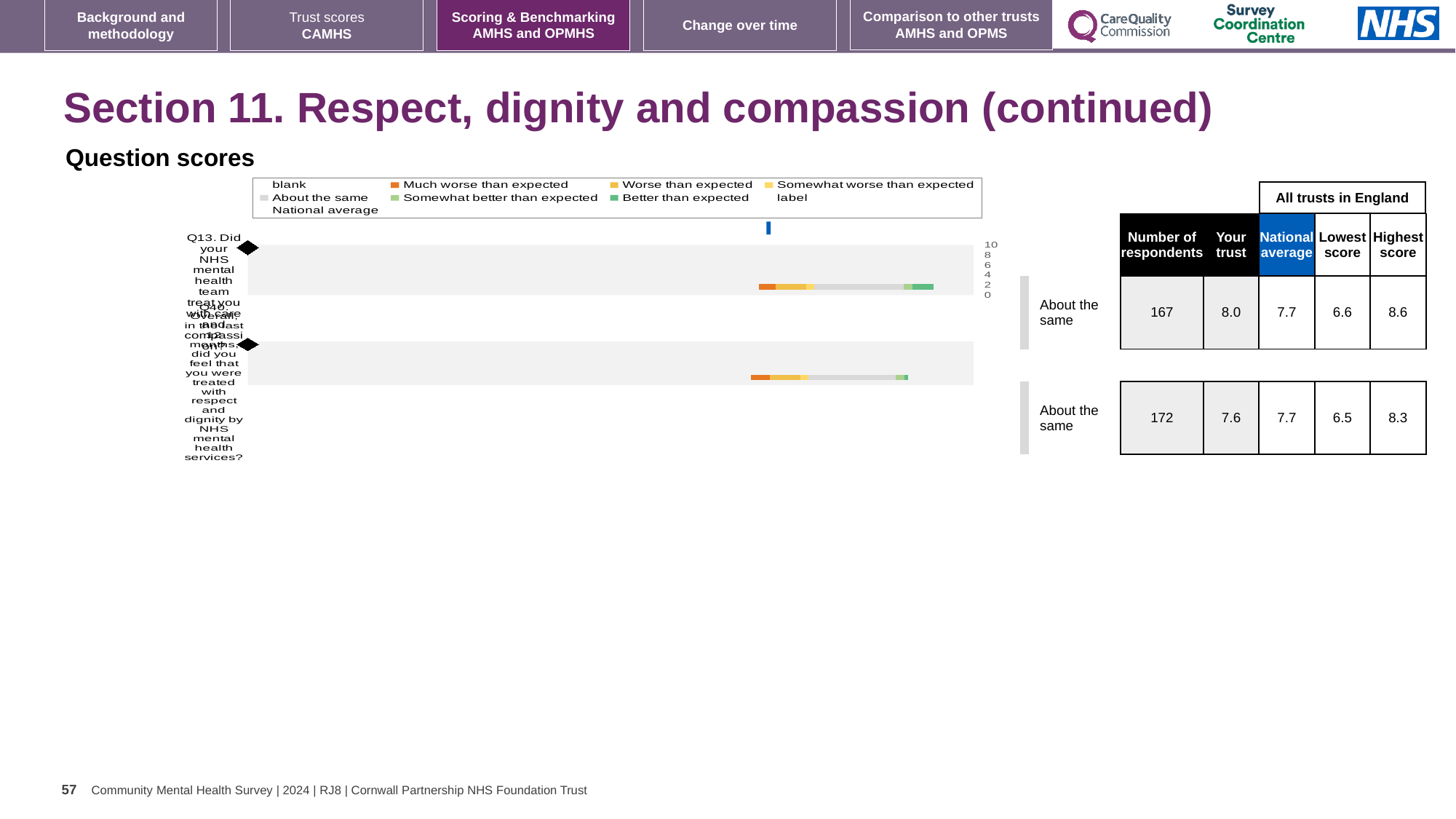
What is the highest value shown on the chart's axis? 10 What kind of chart is shown under 'Question scores'? bar chart How many questions (categories) are plotted in the chart? 2 What is the difference between the 'Your trust' score and the national average for Q13? 0.3 What is the 'Your trust' score for Q13 in the table next to the chart? 8.0 Which question has the higher 'Your trust' score, Q13 or Q10? Q13 What is the difference between the highest score and the lowest score for Q10? 1.8 What is the 'Your trust' score for Q10 in the table next to the chart? 7.6 What is the number of respondents for Q10? 172 Which legend entry is shown in orange in the chart? Much worse than expected How many entries does the chart legend list? 9 What is the highest score across all trusts in England for Q13? 8.6